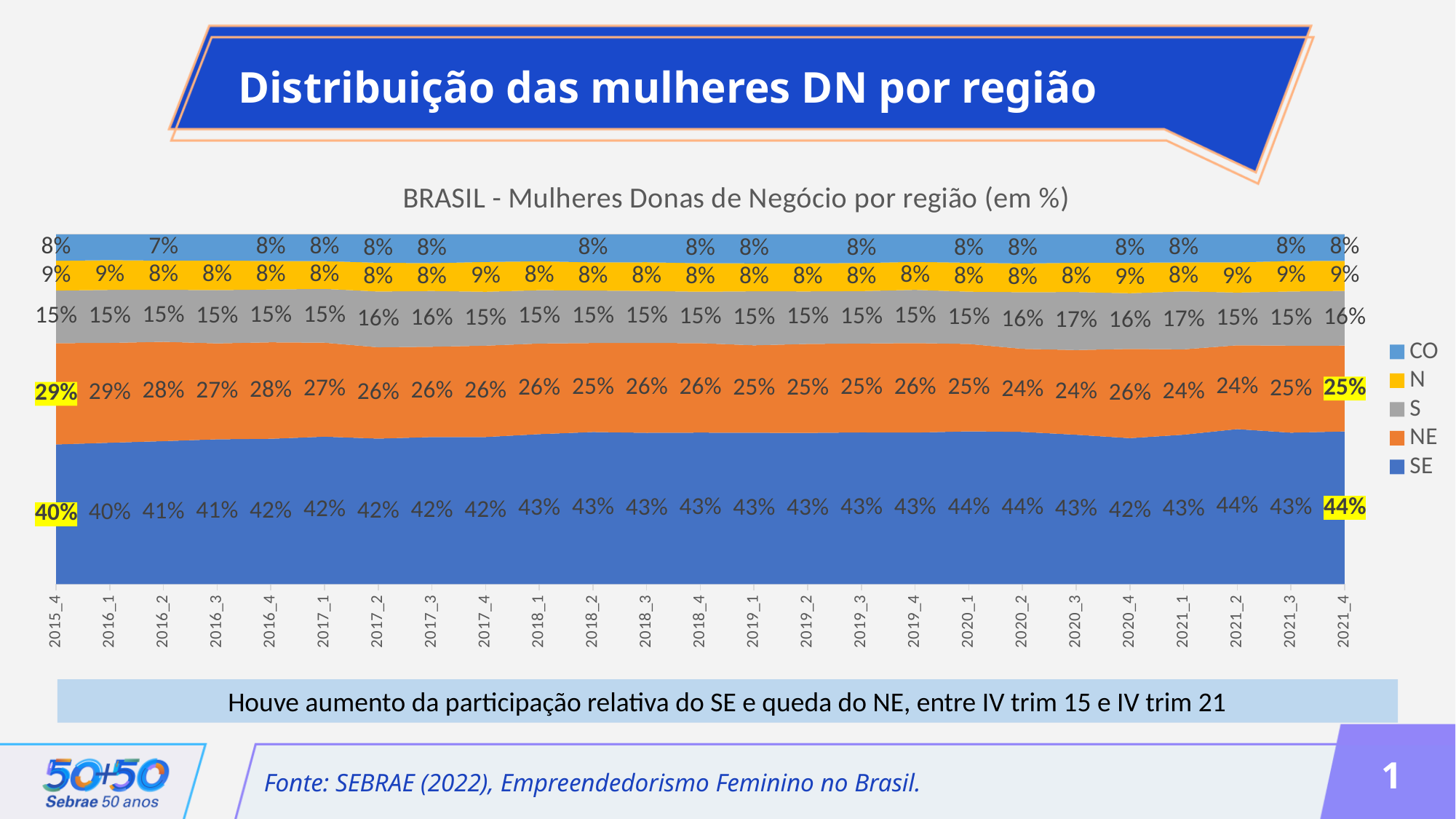
What is the value for NE in 2015_4? 29% How many time points are shown along the x axis? 25 What is the value for S in 2020_3? 17% How many series does the legend list? 5 What is the title of the chart? BRASIL - Mulheres Donas de Negócio por região (em %) Which region has the highest share in 2021_4? SE Which region has the lowest share in 2021_4? CO What is the value for SE in 2021_4? 44% Does the share of NE rise or fall from 2015_4 to 2021_4? Fall In 2015_4, which is larger: the share of NE or the share of S? NE What type of chart is shown on the slide? Stacked area chart By how many percentage points did the SE share change from 2015_4 to 2021_4? 4 percentage points